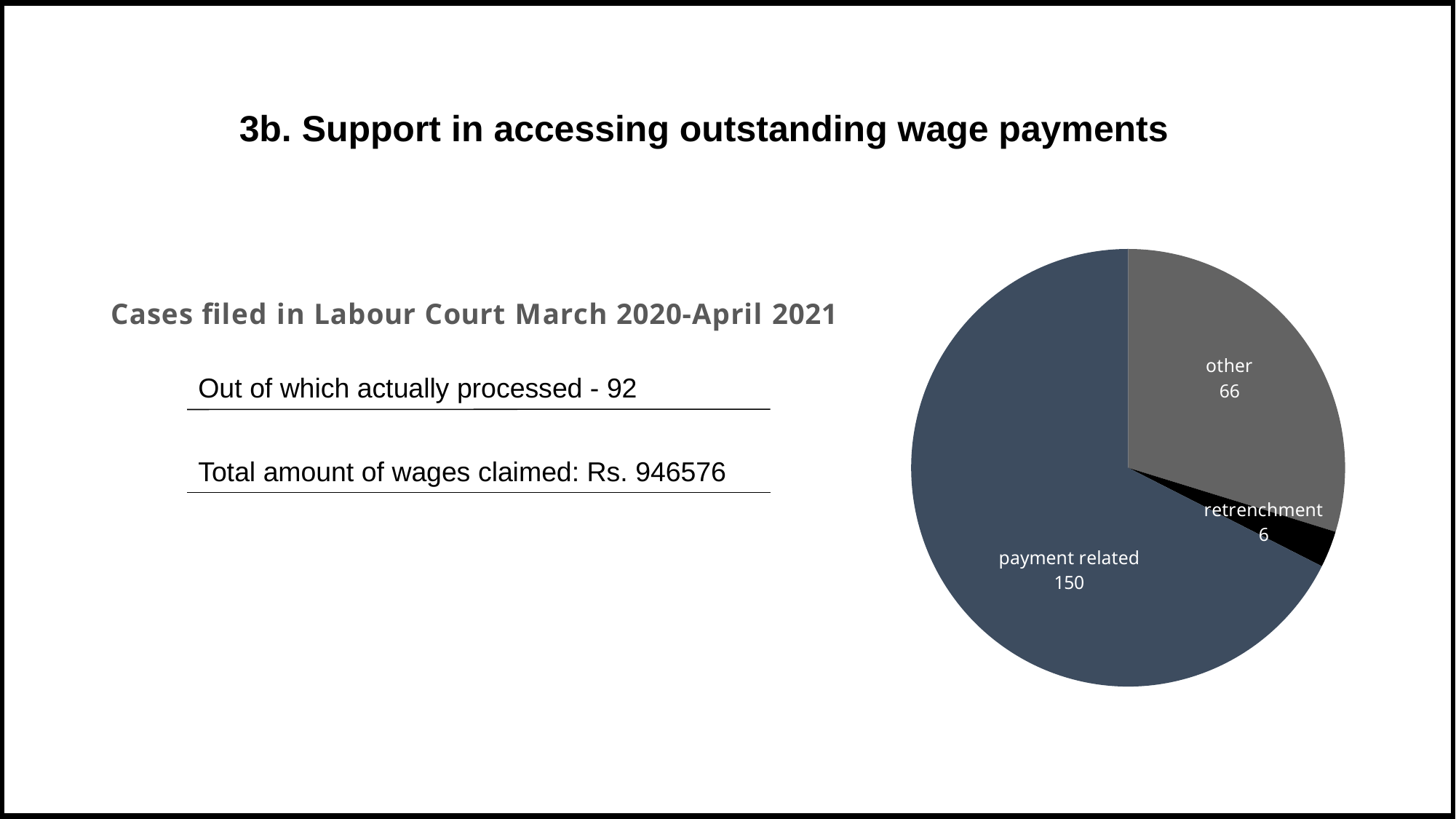
What is the value of the 'payment related' slice in the pie chart? 150 What is the difference between the 'other' and 'retrenchment' values in the pie chart? 60 What colour is the 'retrenchment' slice in the pie chart? black What is the total of all slices in the pie chart? 222 How many slices does the pie chart have? 3 What is the difference between the 'payment related' and 'other' values in the pie chart? 84 What is the value of the 'retrenchment' slice in the pie chart? 6 Which category has the smallest slice in the pie chart? retrenchment Which is larger in the pie chart, 'other' or 'retrenchment'? other Which category has the largest slice in the pie chart? payment related What type of chart is shown on the slide? pie chart What is the value of the 'other' slice in the pie chart? 66